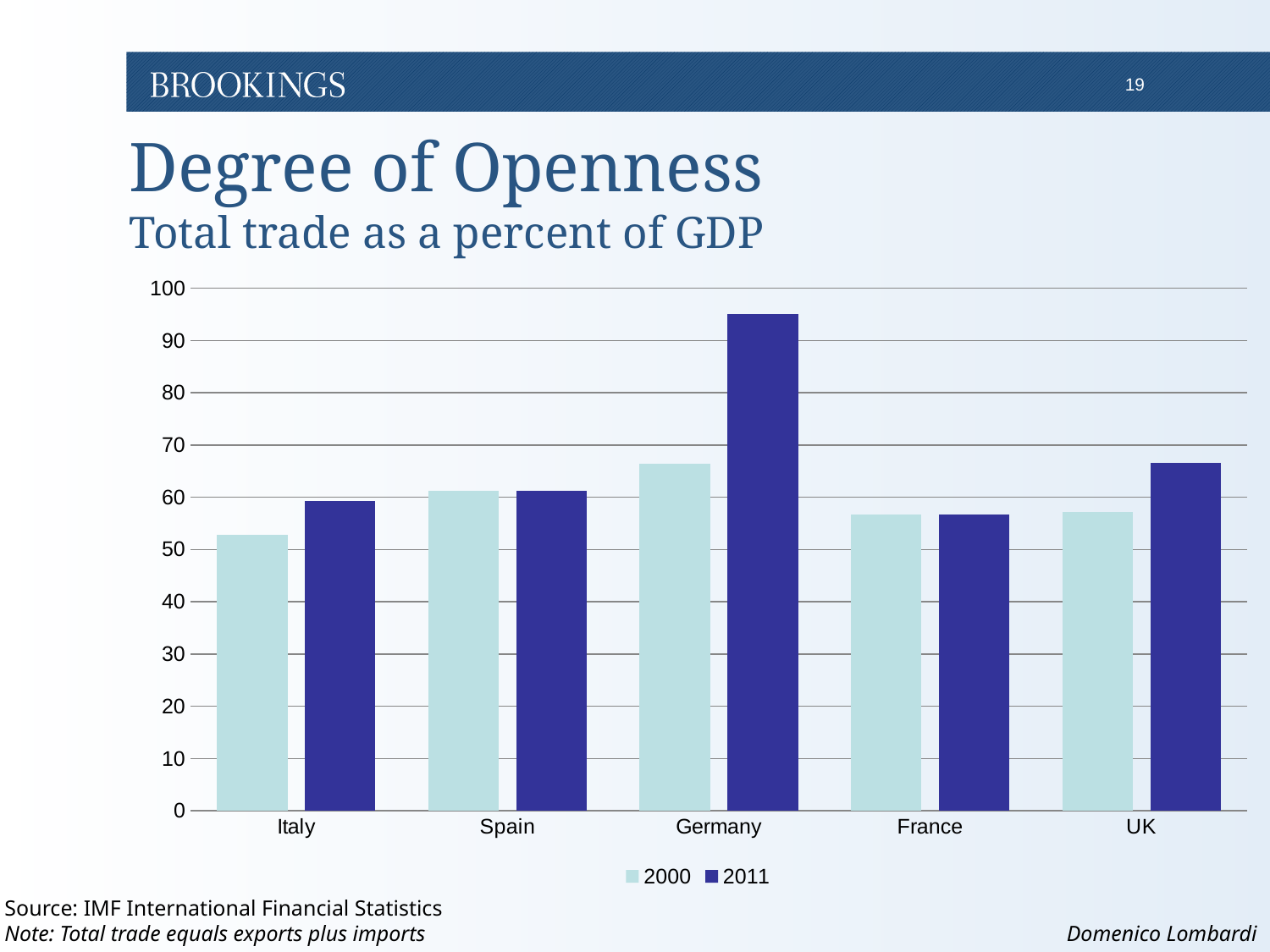
What kind of chart is shown on the slide? bar chart Which country has the highest bar in the chart? Germany Is the 2000 value for France greater or less than 60? less Which country has the lowest bar in the chart? Italy Is the 2000 value for Italy greater or less than 50? greater How many countries are shown on the x axis? 5 Is the 2011 value for Germany greater or less than 90? greater Which series are listed in the legend? 2000 and 2011 For the UK, which year has the larger value, 2000 or 2011? 2011 How many series does the legend list? 2 For Germany, which year has the larger value, 2000 or 2011? 2011